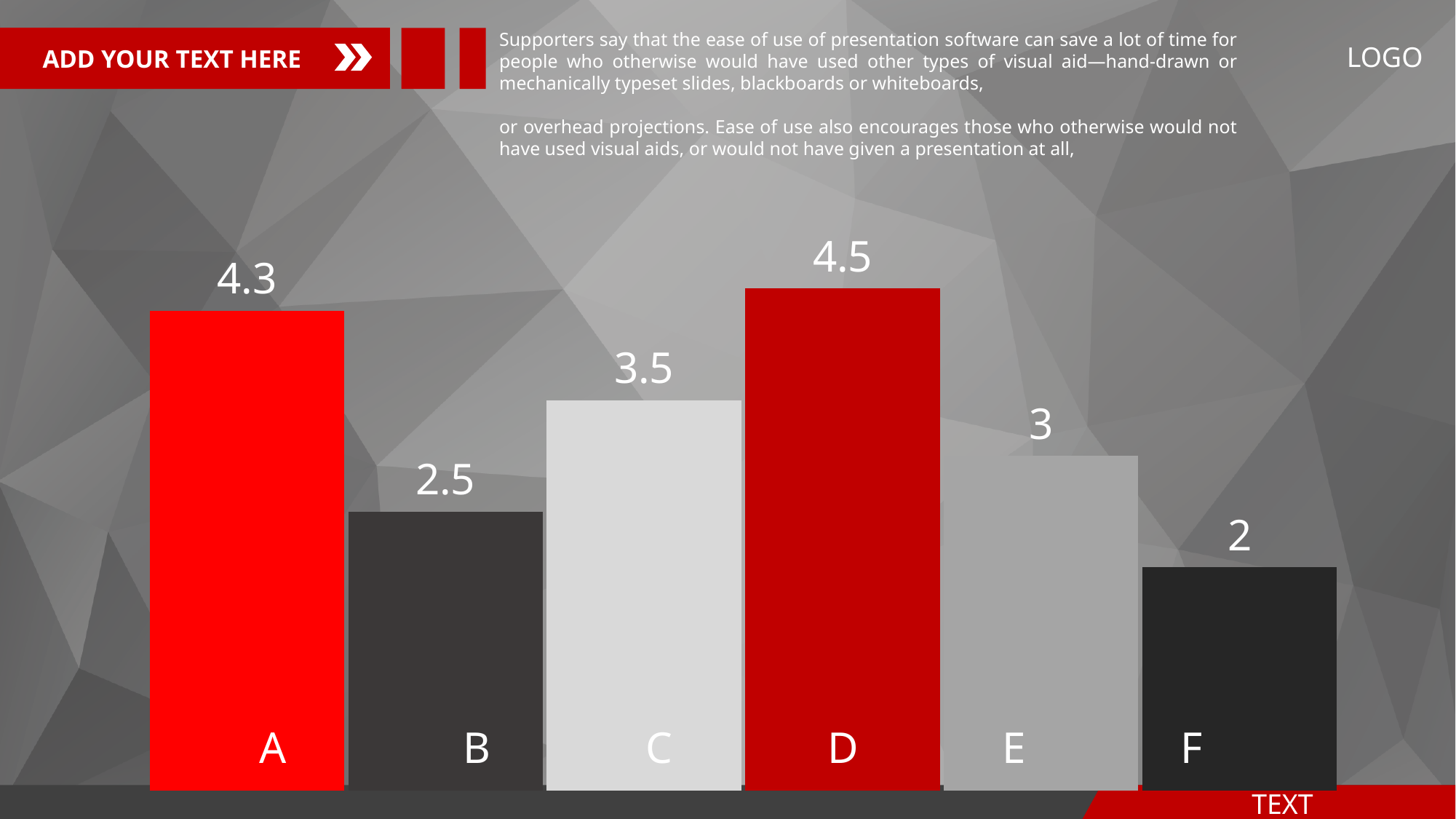
What is the value for category F? 2 Which category has the highest value? D What is the value for category C? 3.5 How many categories are shown in the chart? 6 What kind of chart is shown on the slide? bar chart What is the difference between the values for D and B? 2 What colour is the bar for category D? dark red Which category has the lowest value? F What is the value for category A? 4.3 What is the value for category E? 3 What is the difference between the values for A and E? 1.3 Which is larger, the value for C or the value for E? C